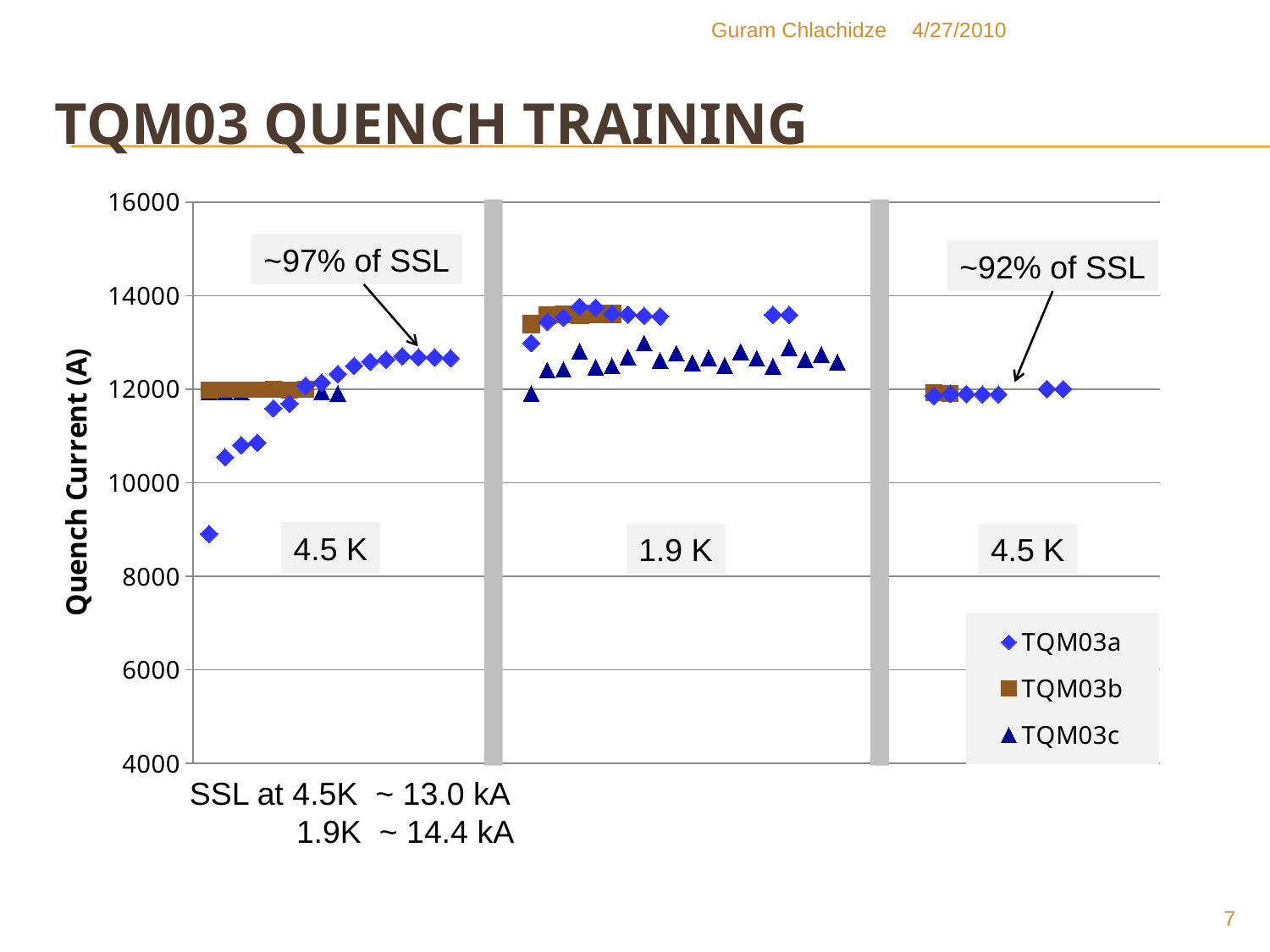
How many temperature regions are marked on the chart? 3 What kind of chart is shown on the slide? scatter chart Which series has the lowest quench currents in the 1.9 K region? TQM03c Are the TQM03b quench currents in the 1.9 K region greater or less than 13000 A? greater Do the TQM03a quench currents rise or fall across the left 4.5 K region? rise How many series does the legend list? 3 Are the TQM03a quench currents higher in the 1.9 K region or in the right-hand 4.5 K region? 1.9 K region What are the three series named in the legend? TQM03a, TQM03b, TQM03c Are the TQM03a quench currents in the right-hand 4.5 K region greater or less than 13000 A? less What is the label of the vertical axis? Quench Current (A) Is the first TQM03a quench in the left 4.5 K region greater or less than 10000 A? less